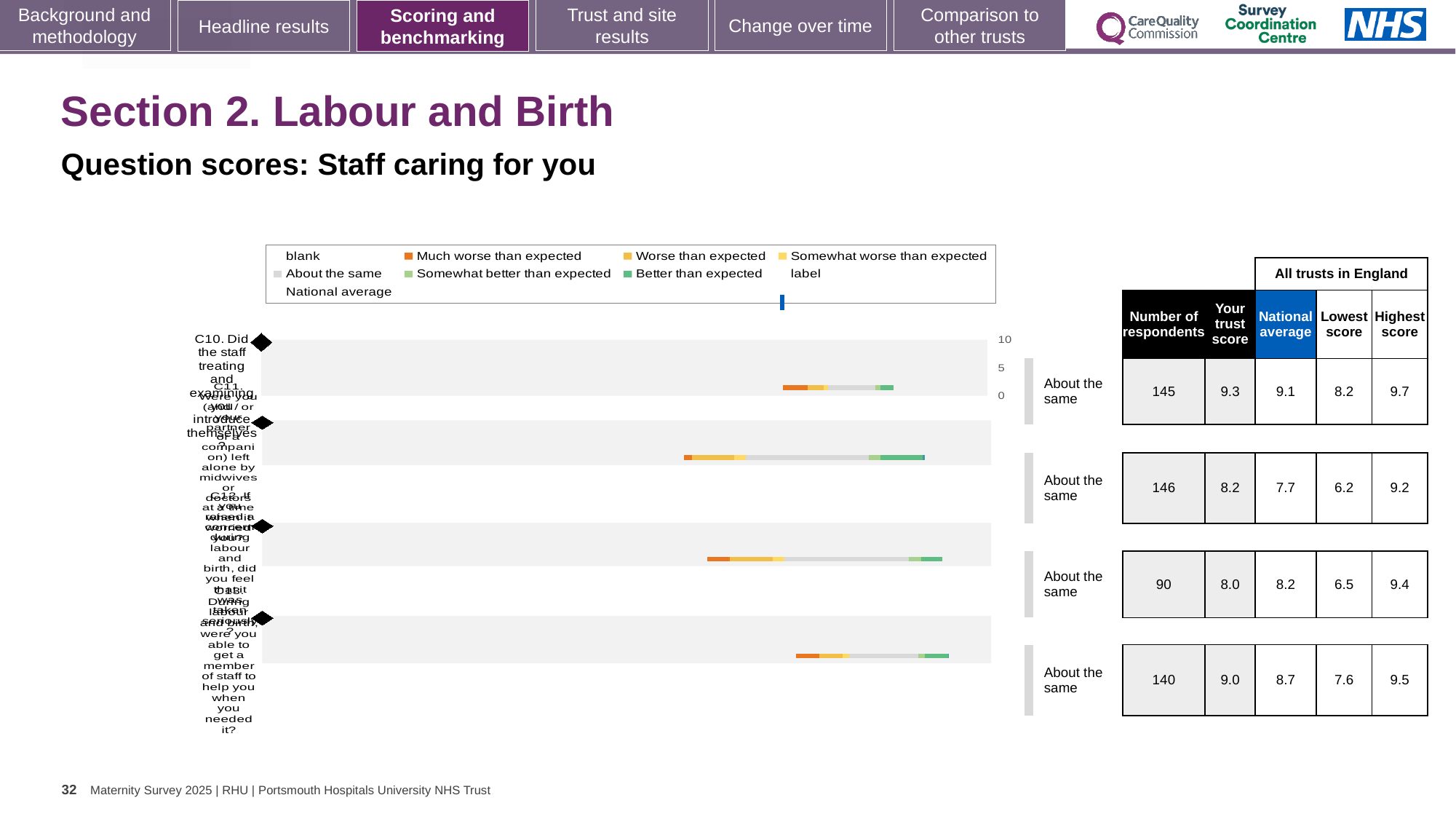
Which question has the highest trust score in the table next to the chart? C10 In the table next to the chart, what is the number of respondents for the first question (C10)? 145 In the table next to the chart, what is the lowest score for the third question (C12)? 6.5 What kind of chart is shown on the slide? bar chart In the table next to the chart, what is the trust score for the first question (C10)? 9.3 In the table next to the chart, what is the national average for the second question (C11)? 7.7 How many survey questions (categories) are plotted in the chart? 4 In the table next to the chart, what is the highest score for the fourth question (C13)? 9.5 In the chart legend, what colour represents 'Much worse than expected'? orange Which question has the fewest respondents in the table next to the chart? C12 In the table next to the chart, what is the difference between the trust score and the national average for the second question (C11)? 0.5 In the chart legend, what colour represents 'Better than expected'? green